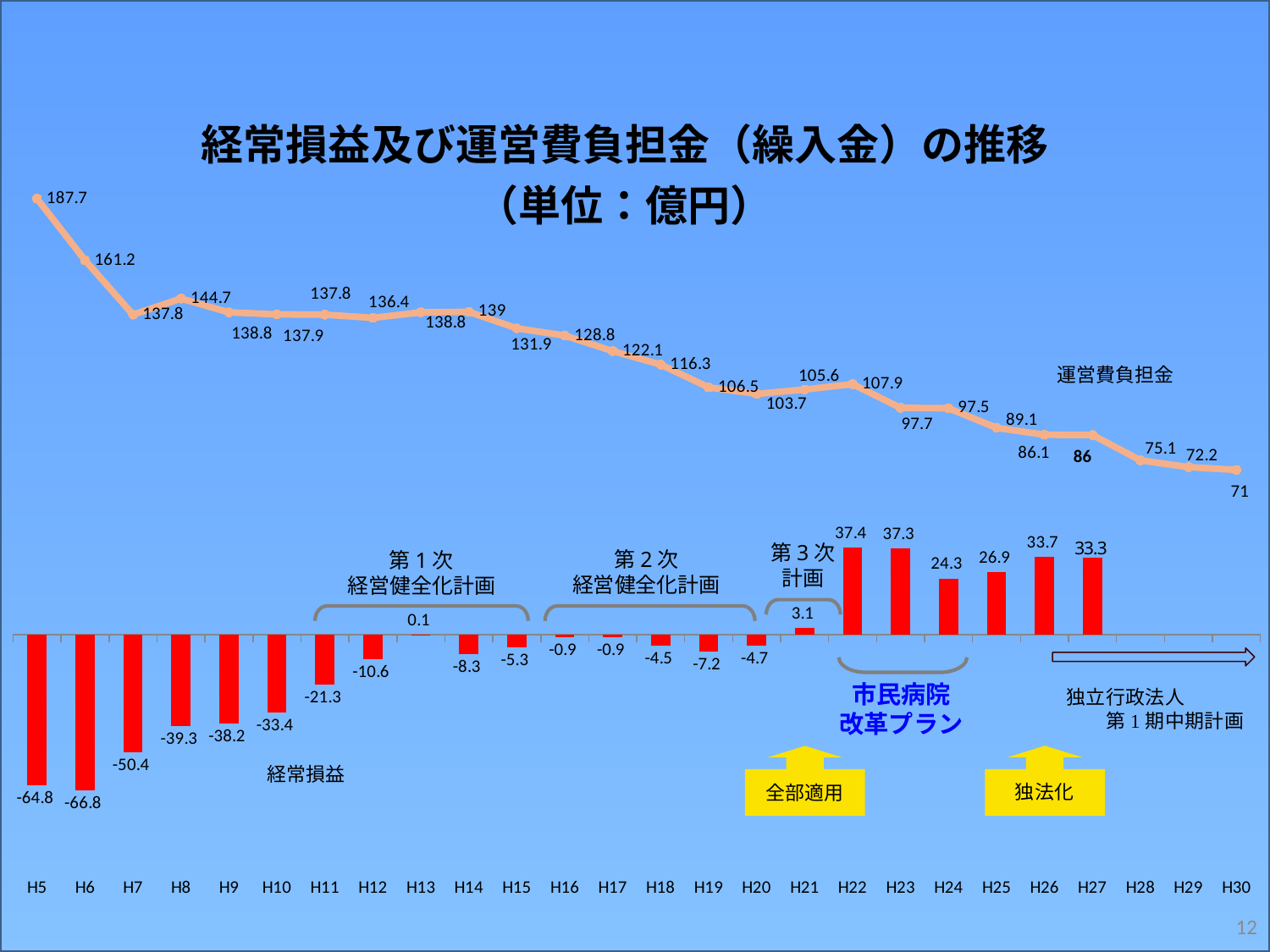
Does the 運営費負担金 line generally rise or fall from H5 to H30? fall What kind of chart is used to show 経常損益? bar chart What is the 経常損益 value for H22? 37.4 Which year has the lowest 経常損益 value? H6 What is the difference between the 運営費負担金 values for H5 and H6? 26.5 Which is larger, the 経常損益 value for H26 or for H24? H26 What is the 運営費負担金 value for H5? 187.7 What unit is stated in the chart title? 億円 What is the 経常損益 value for H6? -66.8 How many year categories are shown on the x axis? 26 What is the 運営費負担金 value for H30? 71 Which year has the highest 運営費負担金 value? H5